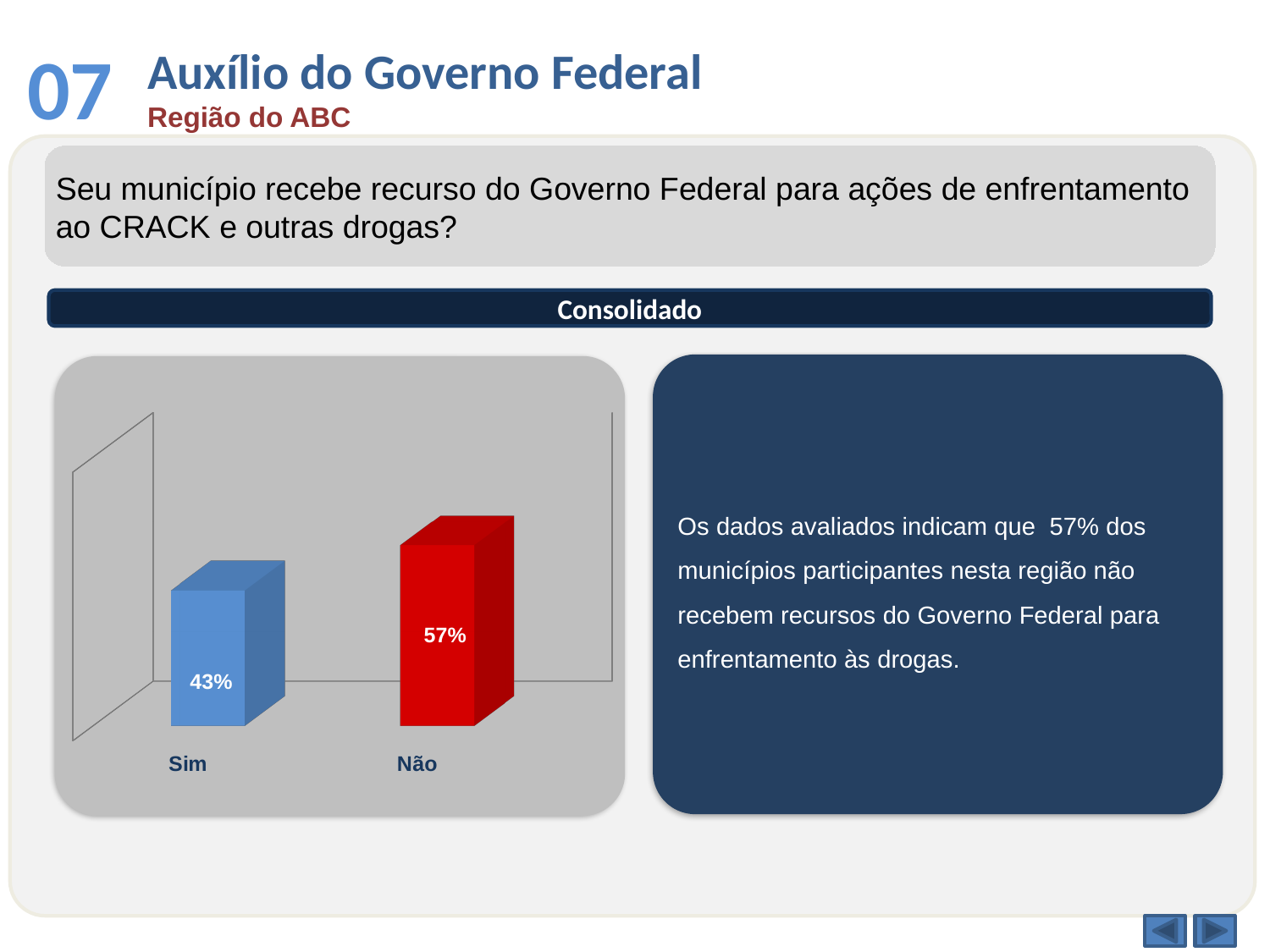
How many categories are shown in the chart? 2 Which category has the highest value? Não What colour is the bar for Sim? Blue What is the difference between the values for Não and Sim? 14% Which is larger, the value for Sim or the value for Não? Não What is the value for Sim? 43% What kind of chart is shown on the slide? Bar chart What colour is the bar for Não? Red Which category has the lowest value? Sim What is the value for Não? 57% What is the total of the two values shown in the chart? 100%